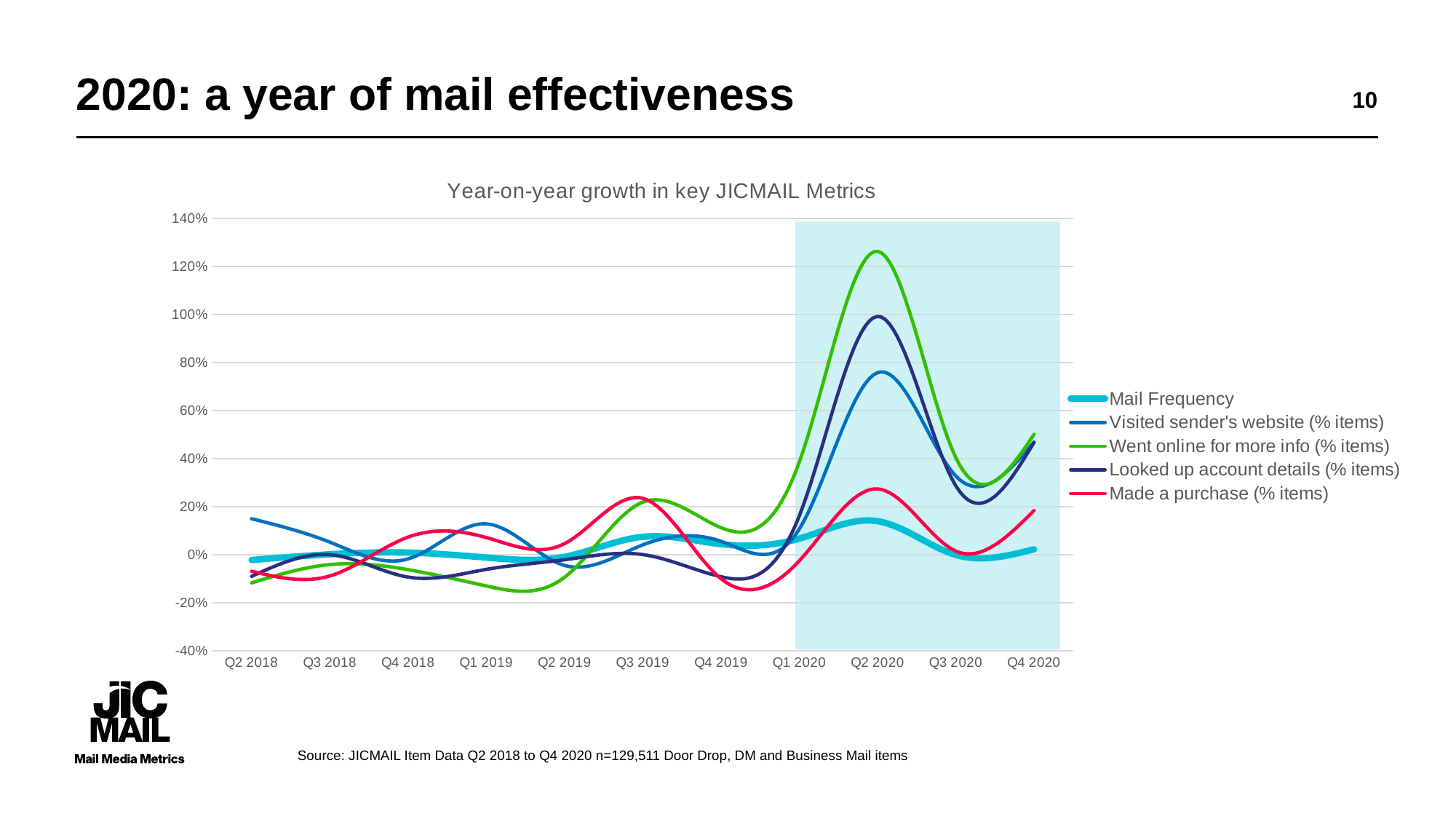
Does the Went online for more info (% items) line rise or fall from Q2 2020 to Q3 2020? Fall In Q2 2020, which is larger: Looked up account details (% items) or Visited sender's website (% items)? Looked up account details (% items) Is the value for Looked up account details (% items) in Q2 2020 greater or less than 80%? greater How many series does the legend list? 5 How many quarters are shown along the x axis? 11 Is the value for Made a purchase (% items) in Q2 2020 greater or less than 40%? less Is the value for Went online for more info (% items) in Q2 2020 greater or less than 120%? greater What type of chart is shown on the slide? Line chart What is the title of the chart? Year-on-year growth in key JICMAIL Metrics Which series reaches the highest value in Q2 2020? Went online for more info (% items) Which series has the lowest value in Q2 2020? Mail Frequency